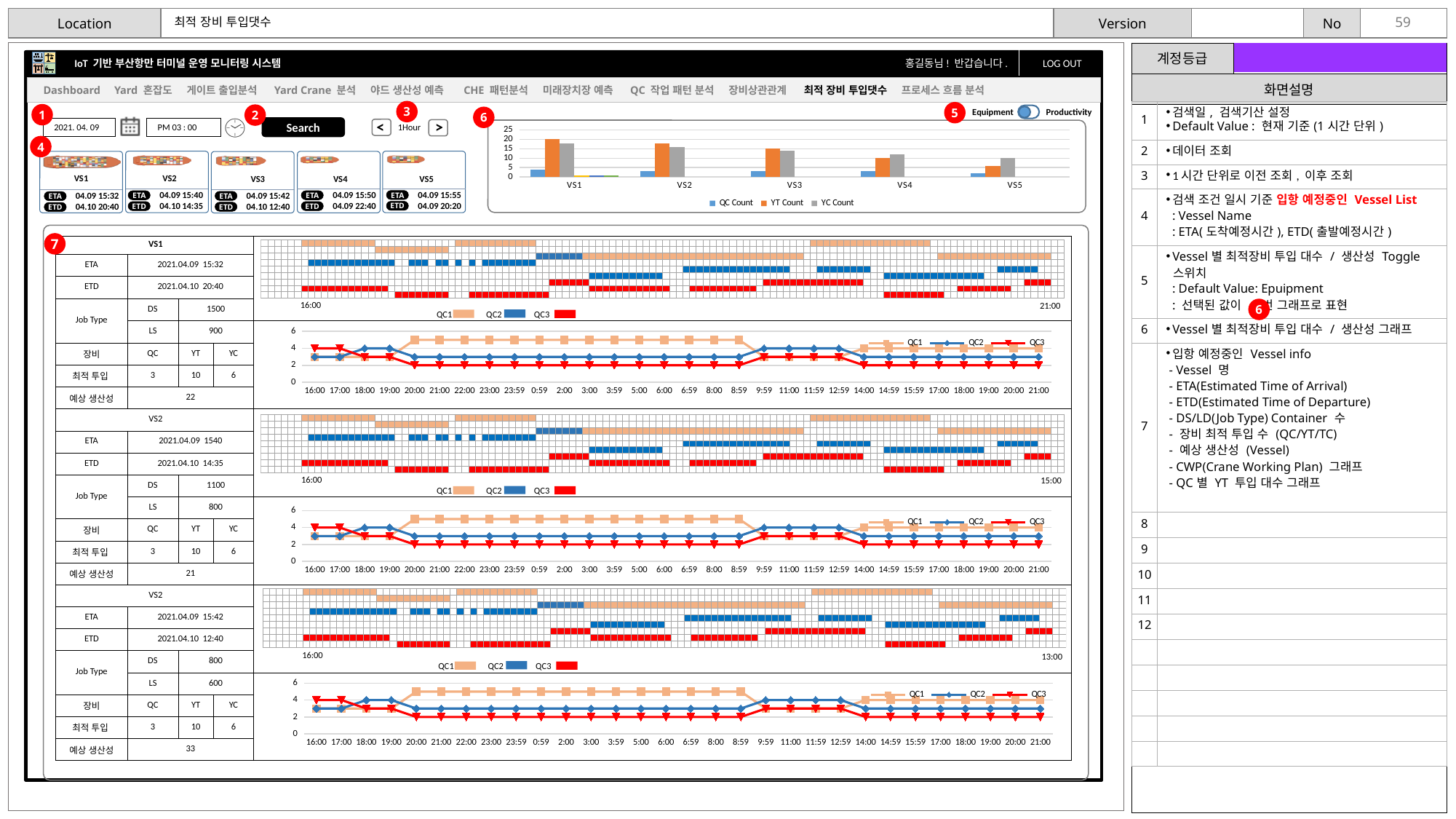
In the top bar chart, is the YT Count for VS5 greater or less than 10? less In the top bar chart, what are the three legend entries? QC Count, YT Count, YC Count In the top bar chart, is the YT Count for VS1 greater or less than 15? greater In the line chart below the VS1 table, how many series does the legend list? 3 In the top bar chart, does the YT Count rise or fall from VS1 to VS5? fall In the top bar chart, how many series does the legend list? 3 In the top bar chart, which vessel has the lowest YT Count? VS5 In the top bar chart, which vessel has the highest YT Count? VS1 In the top bar chart, how many vessel categories are shown on the x axis? 5 What kind of chart is the chart at the top of the slide showing VS1 to VS5? bar chart In the top bar chart, which is larger: the YT Count for VS1 or the YT Count for VS5? VS1